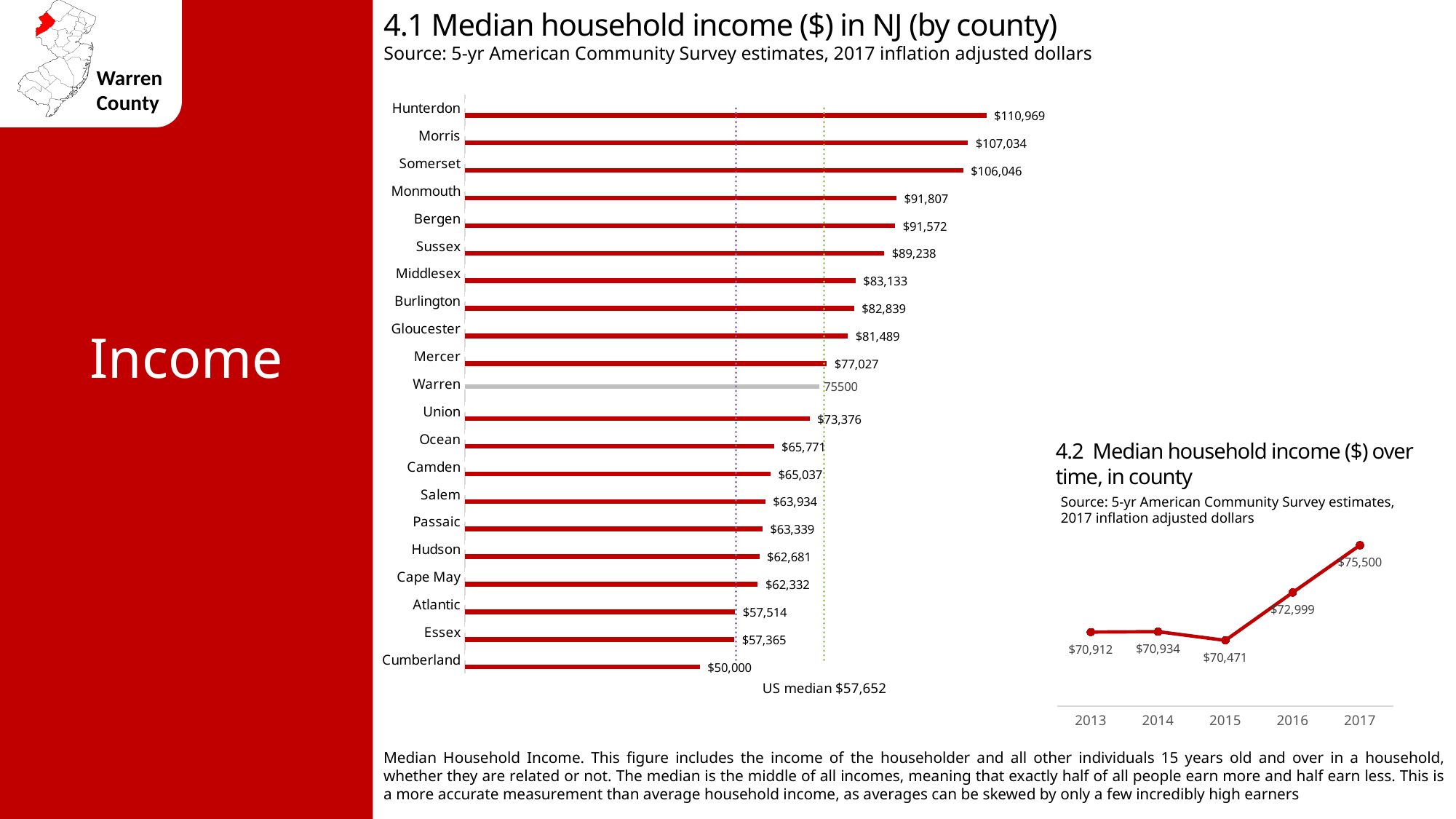
In chart 4.2 (Median household income over time, in county), what is the difference between the 2017 and 2016 values? $2,501 What kind of chart is chart 4.2 (Median household income over time, in county)? Line chart In chart 4.2 (Median household income over time, in county), what was the median household income in 2015? $70,471 In chart 4.1 (Median household income in NJ by county), which county has a higher median household income, Mercer or Union? Mercer What kind of chart is chart 4.1 (Median household income in NJ by county)? Bar chart In chart 4.1 (Median household income in NJ by county), which county has the highest median household income? Hunterdon In chart 4.1 (Median household income in NJ by county), what is the median household income for Hunterdon? $110,969 In chart 4.1 (Median household income in NJ by county), what is the median household income for Warren? 75500 In chart 4.1 (Median household income in NJ by county), how many counties are plotted? 21 In chart 4.2 (Median household income over time, in county), which year has the highest median household income? 2017 In chart 4.1 (Median household income in NJ by county), which county has the lowest median household income? Cumberland In chart 4.1 (Median household income in NJ by county), what is the difference between the median household income of Morris and Somerset? $988